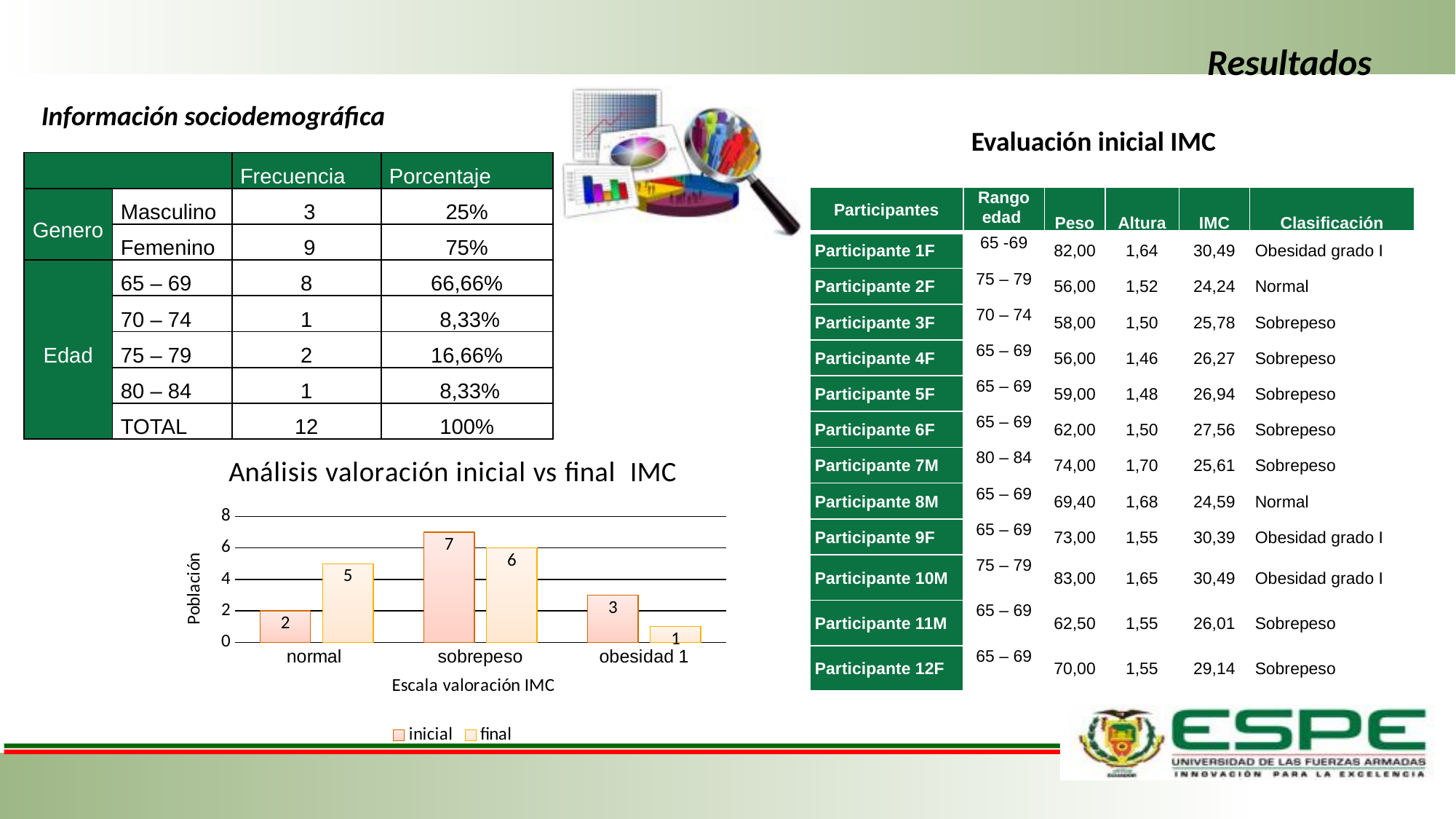
What is the difference between the 'inicial' and 'final' values for 'normal' in the chart 'Análisis valoración inicial vs final IMC'? 3 What is the 'inicial' value for 'sobrepeso' in the chart 'Análisis valoración inicial vs final IMC'? 7 Which category has the lowest 'final' value in the chart 'Análisis valoración inicial vs final IMC'? obesidad 1 What is the x-axis label of the chart 'Análisis valoración inicial vs final IMC'? Escala valoración IMC Which category has the highest 'inicial' value in the chart 'Análisis valoración inicial vs final IMC'? sobrepeso What is the 'final' value for 'obesidad 1' in the chart 'Análisis valoración inicial vs final IMC'? 1 How many series does the legend of the chart 'Análisis valoración inicial vs final IMC' list? 2 What is the y-axis label of the chart 'Análisis valoración inicial vs final IMC'? Población In the chart 'Análisis valoración inicial vs final IMC', which is larger for 'obesidad 1': the 'inicial' value or the 'final' value? inicial What is the 'final' value for 'normal' in the chart 'Análisis valoración inicial vs final IMC'? 5 What kind of chart is 'Análisis valoración inicial vs final IMC'? bar chart How many categories are shown on the x axis of the chart 'Análisis valoración inicial vs final IMC'? 3